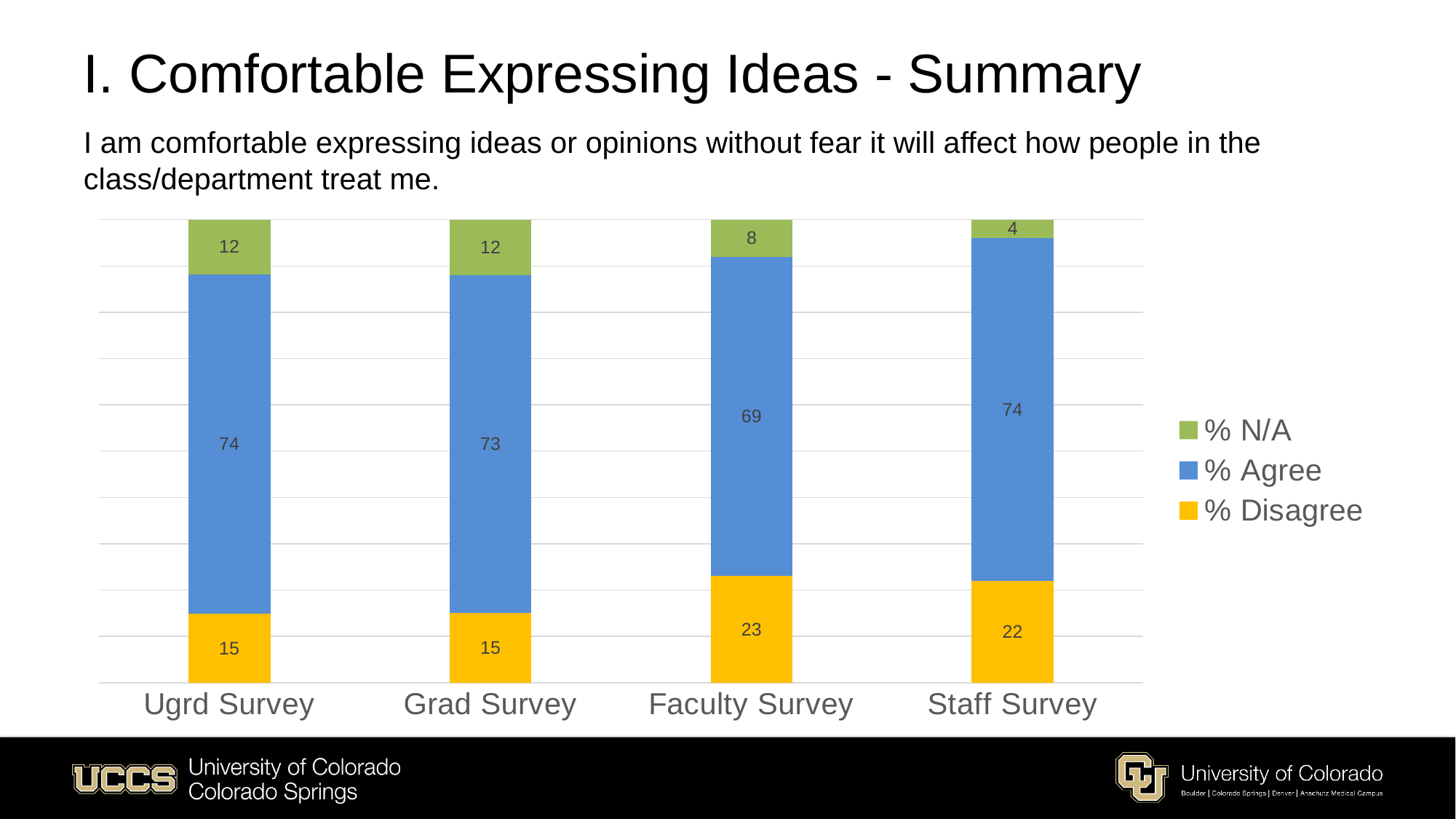
Which colour represents % Disagree in the legend? Yellow What is the % N/A value for the Grad Survey? 12 Which is larger, the % Agree value for the Ugrd Survey or for the Faculty Survey? Ugrd Survey What is the % Agree value for the Faculty Survey? 69 Which survey has the highest % Disagree value? Faculty Survey How many surveys are shown on the x axis? 4 Which survey has the lowest % N/A value? Staff Survey What is the % Disagree value for the Staff Survey? 22 How many series does the legend list? 3 What is the difference between the % Disagree values for the Faculty Survey and the Ugrd Survey? 8 What is the total of the stacked bar for the Staff Survey? 100 What kind of chart is shown on the slide? Stacked bar chart